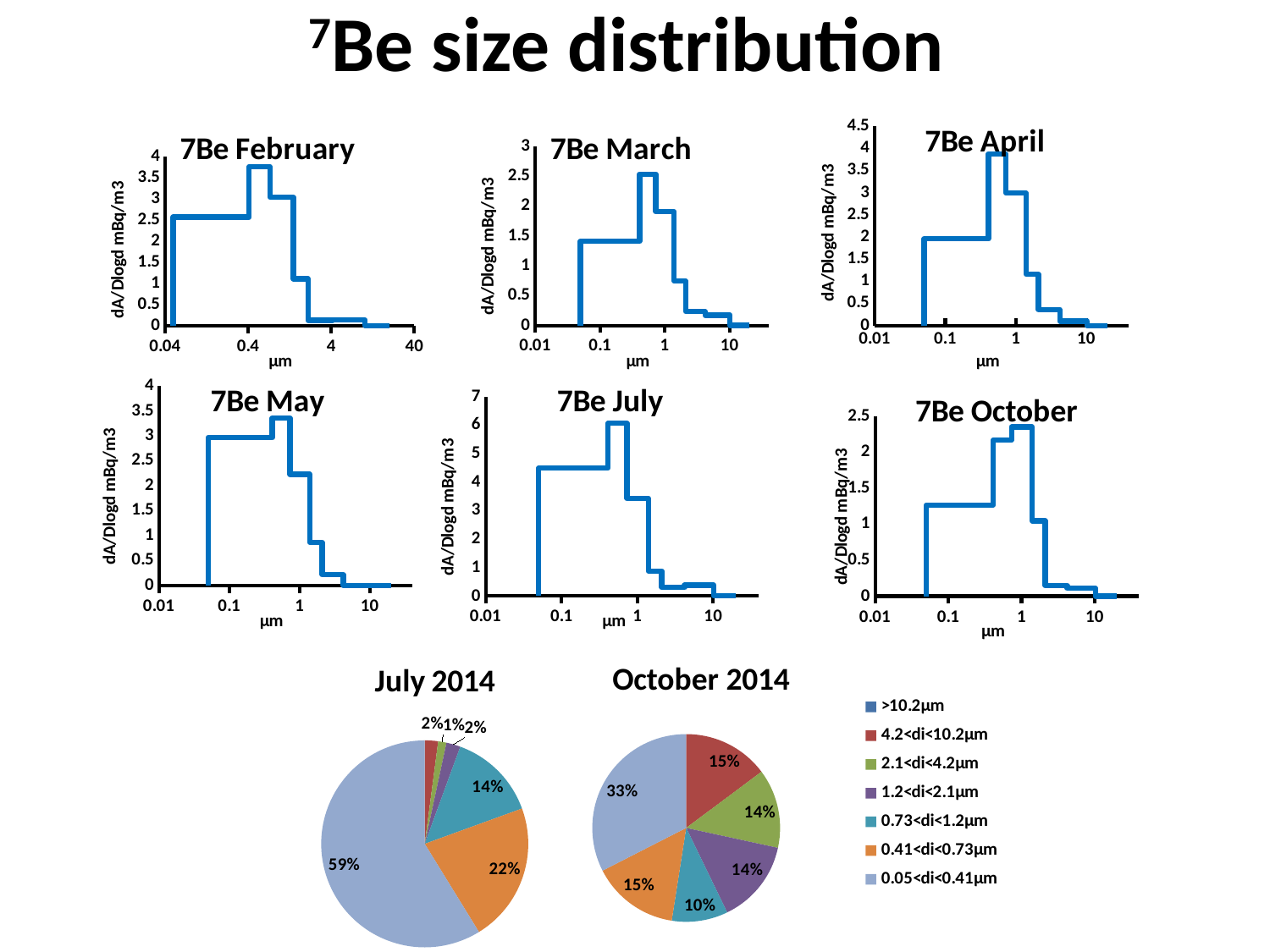
In the October 2014 pie chart, which size range has the largest slice? 0.05<di<0.41µm In the July 2014 pie chart, what share is labelled for the 0.05<di<0.41µm slice? 59% In the October 2014 pie chart, what share is labelled for the 0.05<di<0.41µm slice? 33% How much larger is the 0.05<di<0.41µm share in the July 2014 pie chart than in the October 2014 pie chart? 26 percentage points What kind of chart is the 7Be February chart? line chart In the October 2014 pie chart, which size range has the smallest slice? 0.73<di<1.2µm In the 7Be March chart, is the peak value greater or less than 2? greater In the October 2014 pie chart, what share is labelled for the 0.73<di<1.2µm slice? 10% In the July 2014 pie chart, which slice is larger: 0.41<di<0.73µm or 0.73<di<1.2µm? 0.41<di<0.73µm How many size ranges does the legend next to the pie charts list? 7 In the 7Be July chart, is the peak value greater or less than 5? greater In the July 2014 pie chart, what share is labelled for the 0.41<di<0.73µm slice? 22%